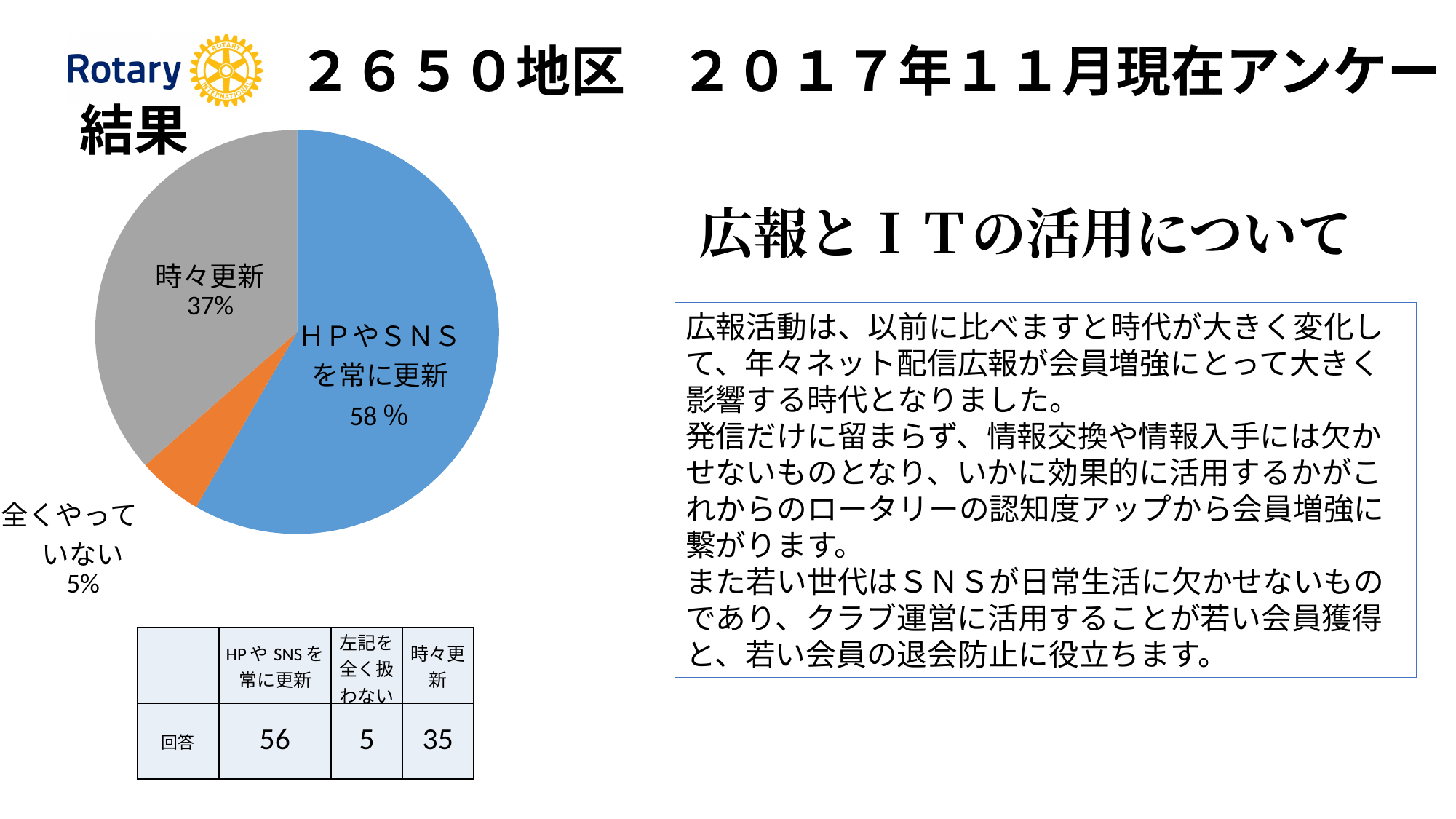
What percentage does the pie chart show for ＨＰやＳＮＳを常に更新? 58％ What colour is the 時々更新 slice in the pie chart? grey What percentage does the pie chart show for 全くやっていない? 5% Which is larger in the pie chart, 時々更新 or 全くやっていない? 時々更新 How many slices does the pie chart have? 3 What kind of chart is shown on the slide? pie chart What is the difference in percentage points between ＨＰやＳＮＳを常に更新 and 時々更新 in the pie chart? 21 Which slice of the pie chart is the smallest? 全くやっていない What is the difference in percentage points between 時々更新 and 全くやっていない in the pie chart? 32 Which slice of the pie chart is the largest? ＨＰやＳＮＳを常に更新 What percentage does the pie chart show for 時々更新? 37% What colour is the 全くやっていない slice in the pie chart? orange